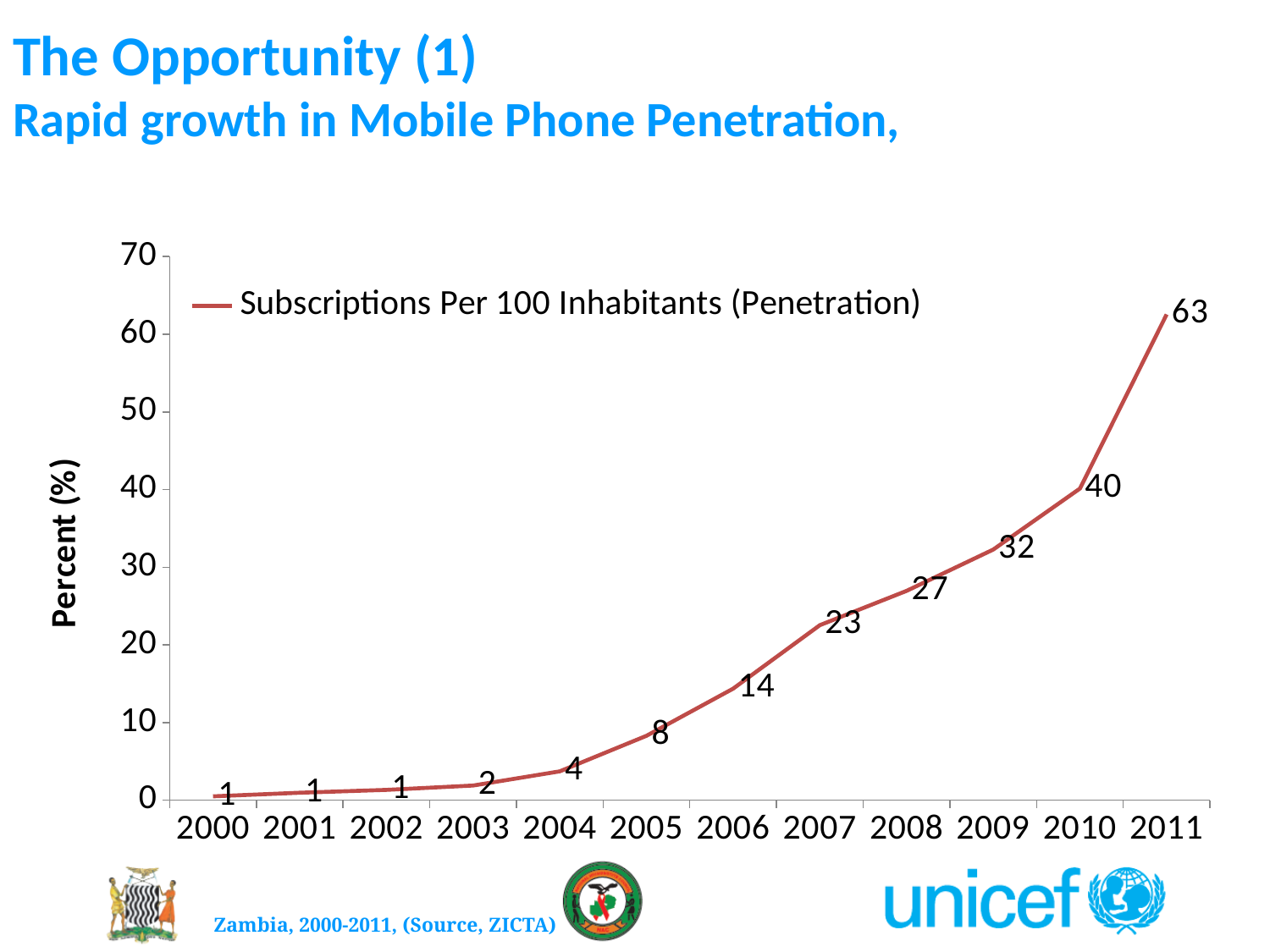
What is the value for 2007? 23 How many series does the legend list? 1 What is the value for 2011? 63 What is the difference between the values for 2009 and 2006? 18 What is the value for 2005? 8 Do the values rise or fall from 2000 to 2011? rise What is the difference between the values for 2011 and 2010? 23 How many years are plotted on the x axis? 12 Which is larger, the value for 2008 or the value for 2006? 2008 Which year has the highest value? 2011 Is the value for 2010 greater or less than 30? greater What kind of chart is shown? line chart